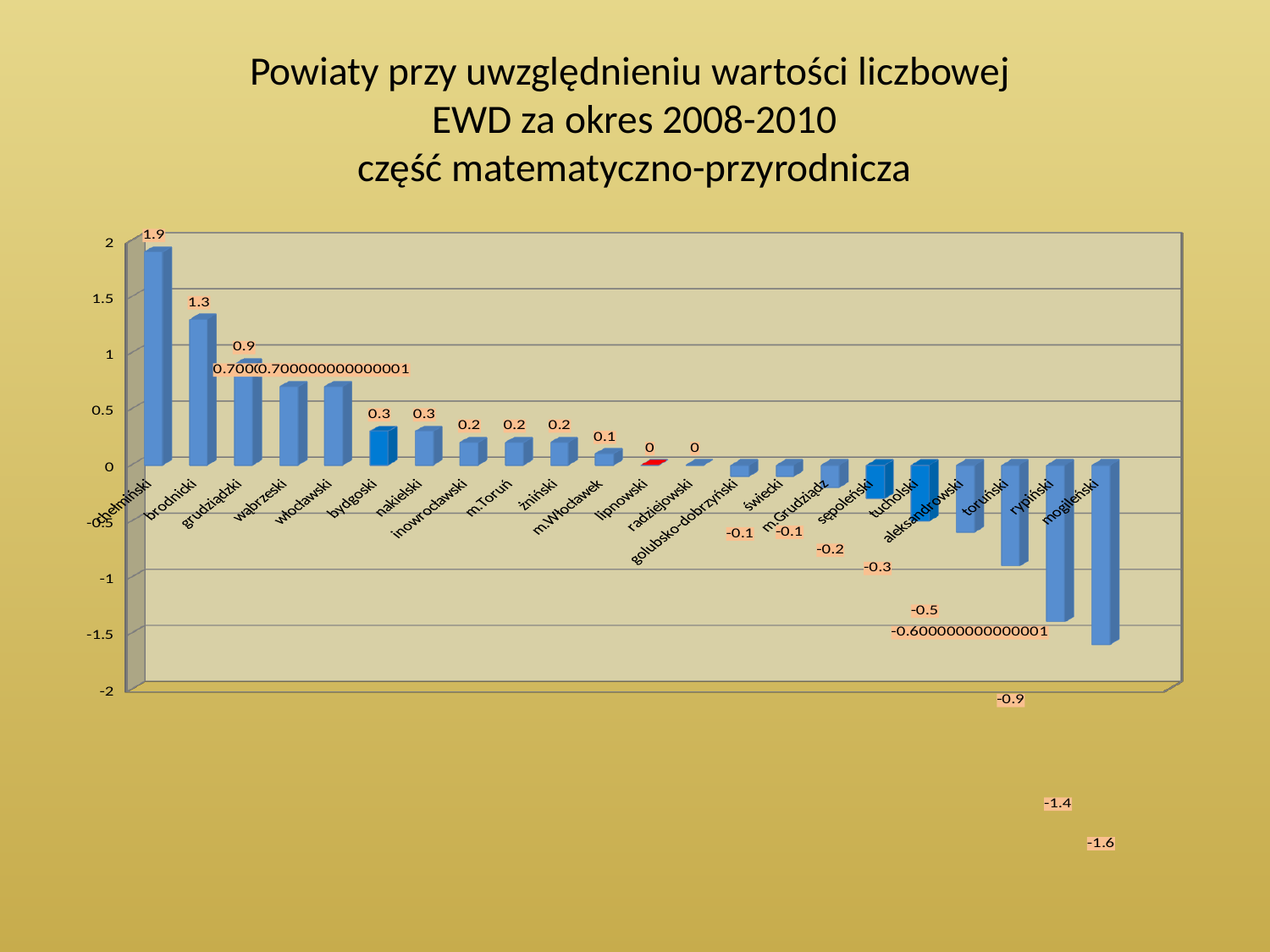
Which has a larger value, grudziądzki or bydgoski? grudziądzki What is the value for chełmiński? 1.9 How many powiaty are shown on the chart? 22 What is the value for brodnicki? 1.3 What is the difference between the values for chełmiński and brodnicki? 0.6 Is the value for chełmiński greater or less than 1.5? greater What kind of chart is shown on the slide? bar chart Which powiat has the highest value? chełmiński Do the values rise or fall from left to right along the x axis? fall Which powiat has the lowest value? mogileński What is the value for rypiński? -1.4 What is the value for mogileński? -1.6